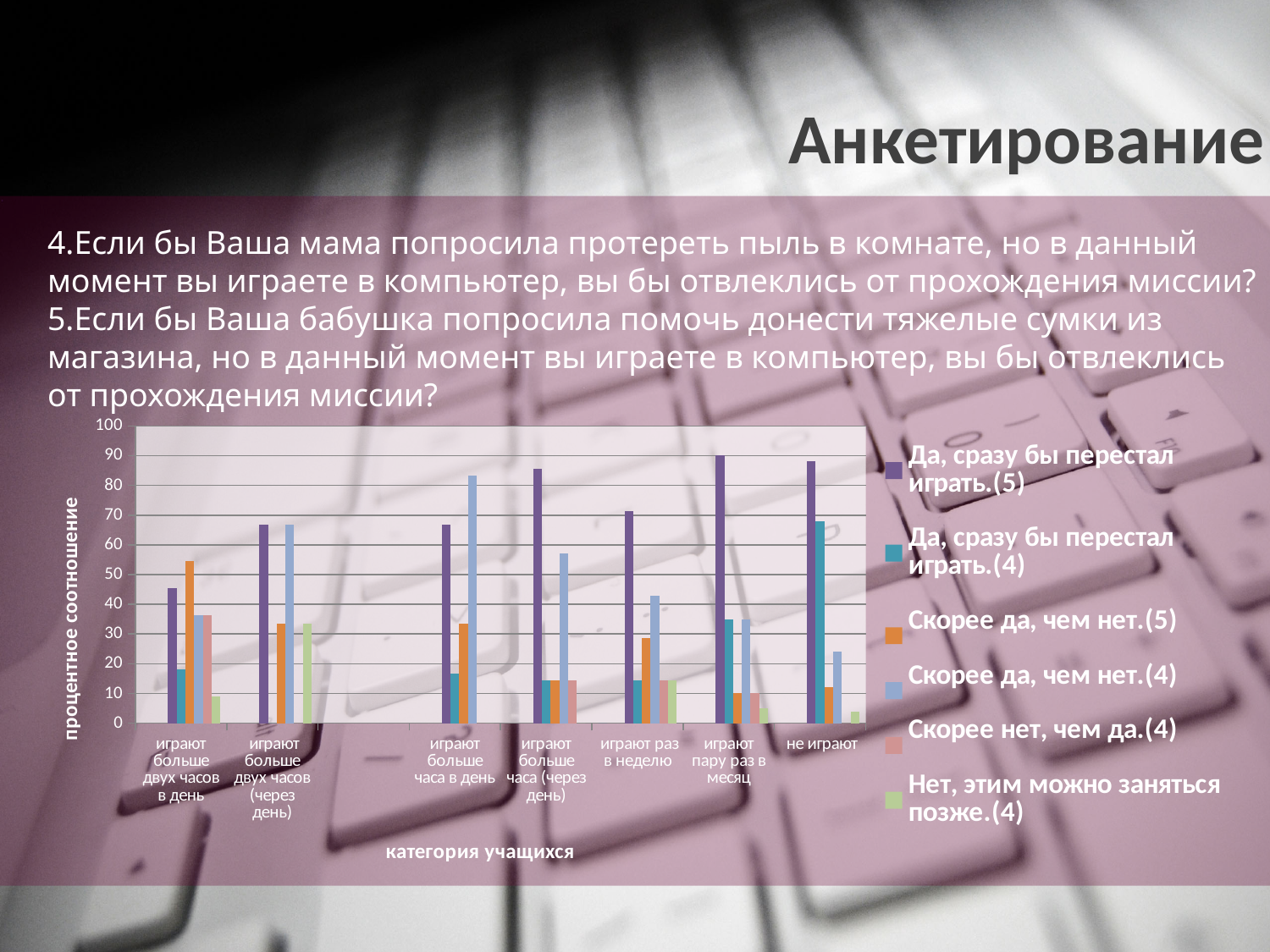
Which category has the highest value for "Скорее да, чем нет.(4)"? играют больше часа в день Is the value of "Нет, этим можно заняться позже.(4)" for "не играют" greater or less than 10? less How many series does the chart legend list? 6 For "играют больше двух часов в день", which is larger: "Да, сразу бы перестал играть.(5)" or "Скорее да, чем нет.(5)"? Скорее да, чем нет.(5) Which category has the lowest value for "Да, сразу бы перестал играть.(5)"? играют больше двух часов в день Is the value of "Да, сразу бы перестал играть.(5)" for "играют больше двух часов в день" greater or less than 50? less How many categories are labelled on the x axis of the chart? 7 What is the title of the vertical axis of the chart? процентное соотношение Is the value of "Да, сразу бы перестал играть.(5)" for "не играют" greater or less than 80? greater For "не играют", which is larger: "Да, сразу бы перестал играть.(5)" or "Да, сразу бы перестал играть.(4)"? Да, сразу бы перестал играть.(5) What kind of chart is shown on the slide? bar chart